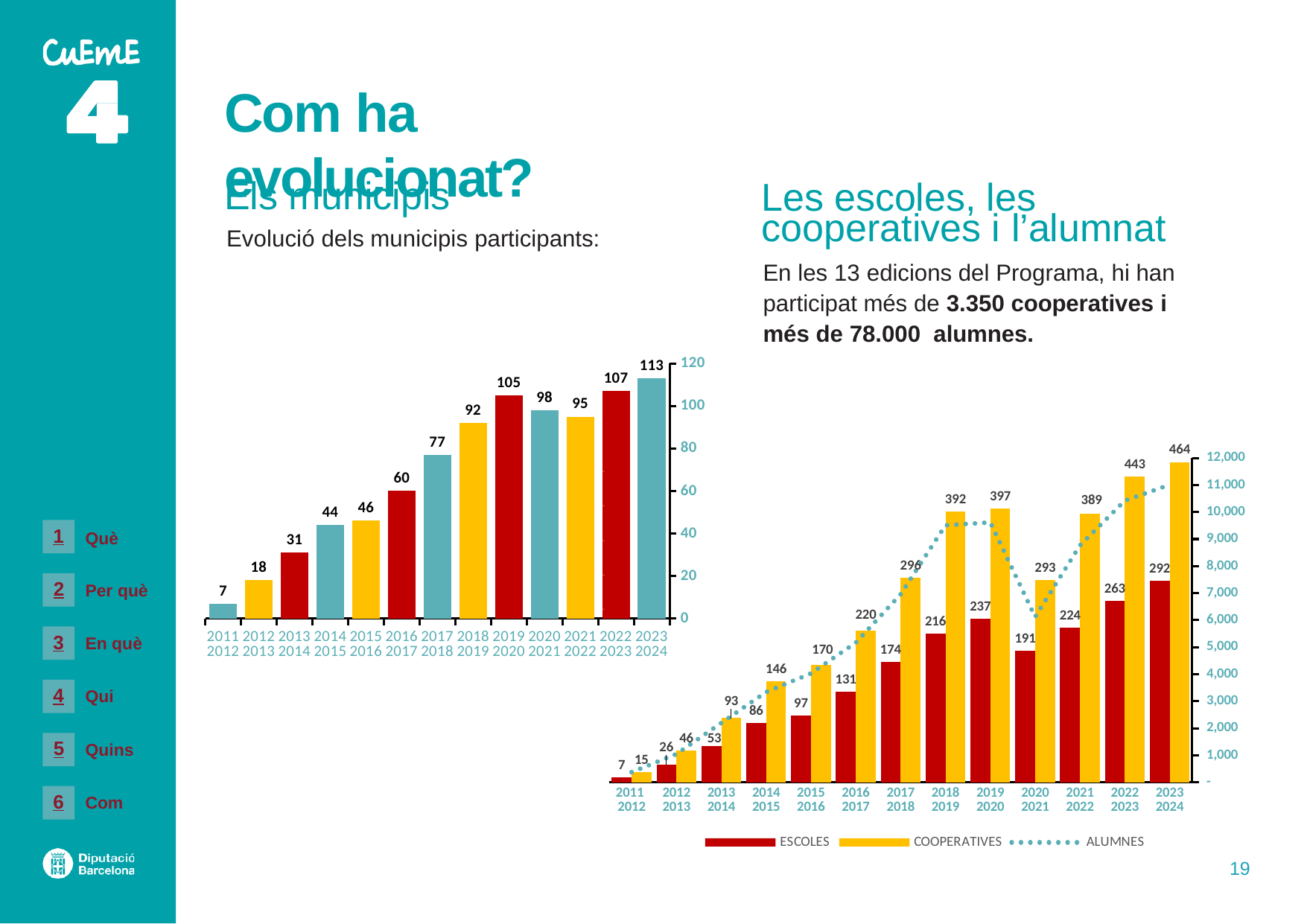
In the right chart (Les escoles, les cooperatives i l'alumnat), how many series does the legend list? 3 In the right chart (Les escoles, les cooperatives i l'alumnat), what is the COOPERATIVES value for 2023-2024? 464 In the right chart (Les escoles, les cooperatives i l'alumnat), what is the ESCOLES value for 2020-2021? 191 In the left chart (Els municipis), which edition has the lowest value? 2011 2012 In the right chart (Les escoles, les cooperatives i l'alumnat), is the ALUMNES value for 2023-2024 greater or less than 10,000? greater In the left chart (Els municipis), what is the difference between the 2019-2020 value and the 2020-2021 value? 7 In the left chart (Els municipis), how many editions (bars) are plotted? 13 In the right chart (Les escoles, les cooperatives i l'alumnat), which series is drawn as a dotted line? ALUMNES In the left chart (Els municipis), what is the value for 2017-2018? 77 In the right chart (Les escoles, les cooperatives i l'alumnat), which edition has the highest COOPERATIVES value? 2023 2024 In the left chart (Els municipis), how many participating municipalities are shown for 2023-2024? 113 In the right chart (Les escoles, les cooperatives i l'alumnat), what is the difference between the COOPERATIVES and ESCOLES values for 2018-2019? 176